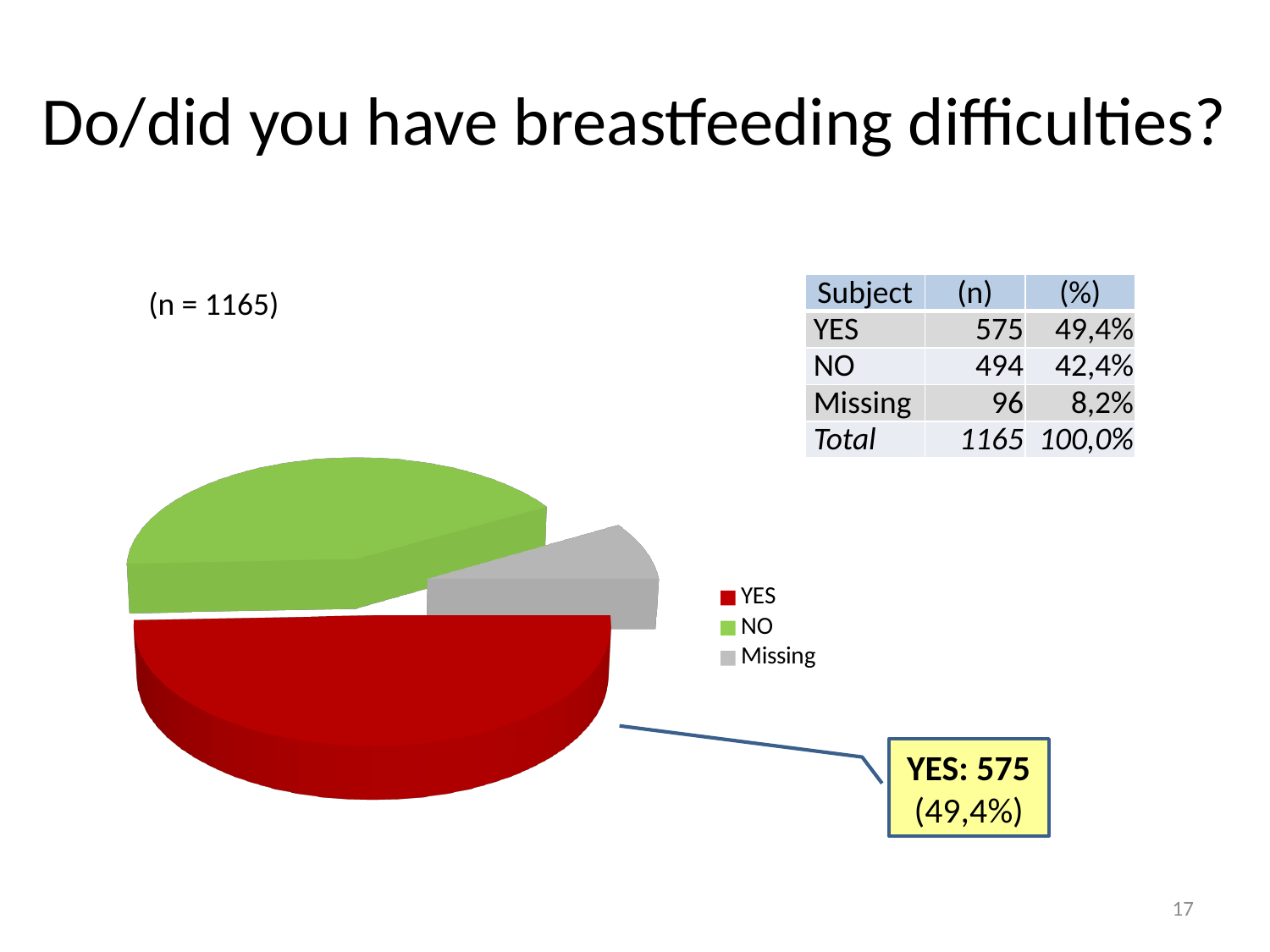
Which category has the smallest slice in the pie chart? Missing What colour is the YES slice in the pie chart? Red Which category has the largest slice in the pie chart? YES Which is larger, the NO slice or the Missing slice? NO How many entries does the legend of the pie chart list? 3 What percentage share does the YES slice represent? 49,4% What kind of chart is shown on the slide? Pie chart What is the count (n) for the NO category? 494 How many slices does the pie chart have? 3 What is the difference in count between YES and NO? 81 What percentage share does the Missing slice represent? 8,2% What is the count (n) for the YES slice of the pie chart? 575